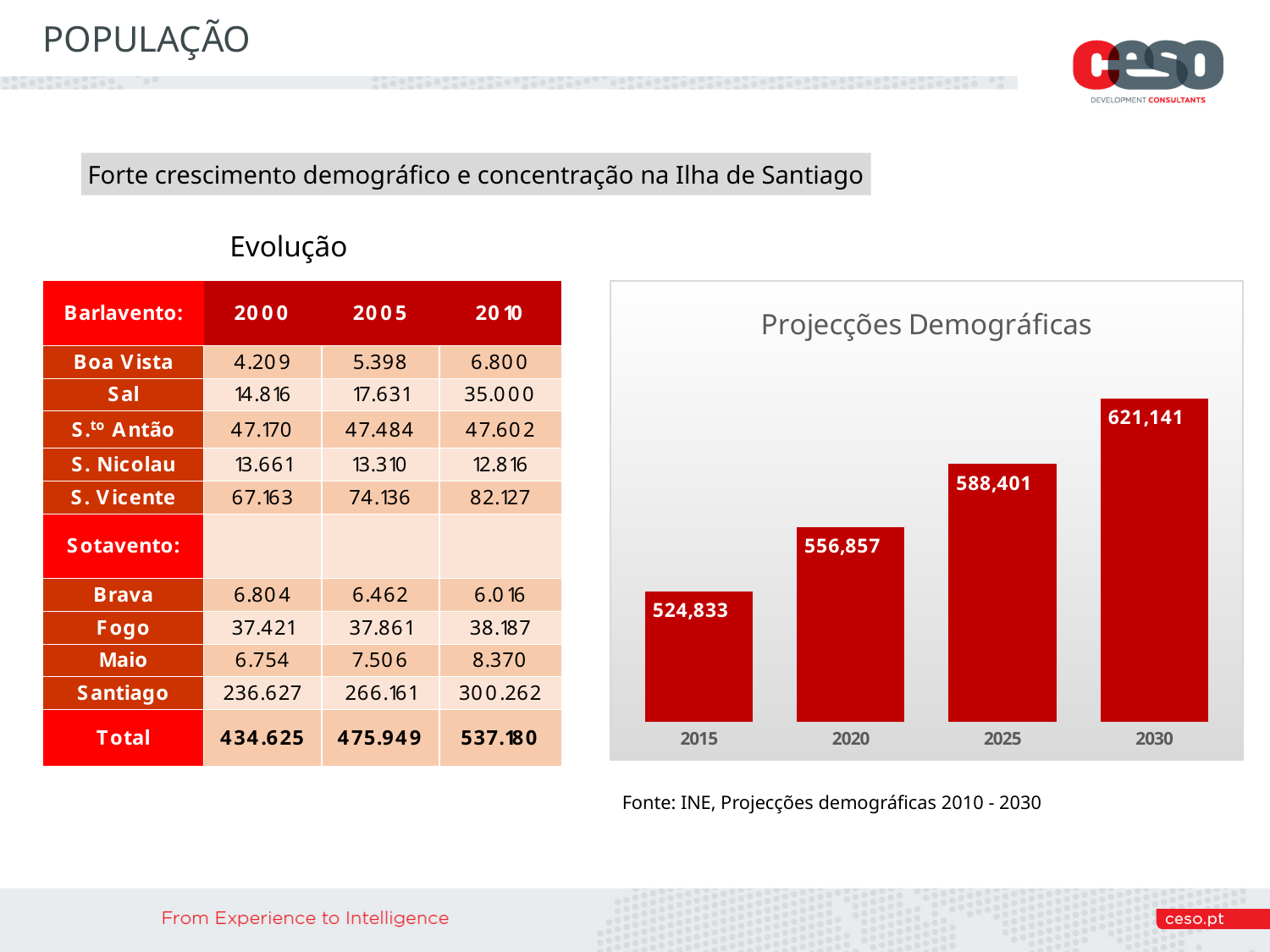
Which year has the lowest value in the "Projecções Demográficas" chart? 2015 What is the difference between the values for 2020 and 2015 in the "Projecções Demográficas" chart? 32,024 What type of chart is "Projecções Demográficas"? bar chart Which year has the highest value in the "Projecções Demográficas" chart? 2030 What is the value for 2030 in the "Projecções Demográficas" chart? 621,141 What is the value for 2020 in the "Projecções Demográficas" chart? 556,857 In the "Projecções Demográficas" chart, which is larger, the value for 2025 or the value for 2020? 2025 Do the values in the "Projecções Demográficas" chart rise or fall from 2015 to 2030? rise What is the value for 2015 in the "Projecções Demográficas" chart? 524,833 What is the difference between the values for 2030 and 2015 in the "Projecções Demográficas" chart? 96,308 What is the value for 2025 in the "Projecções Demográficas" chart? 588,401 How many bars are shown in the "Projecções Demográficas" chart? 4